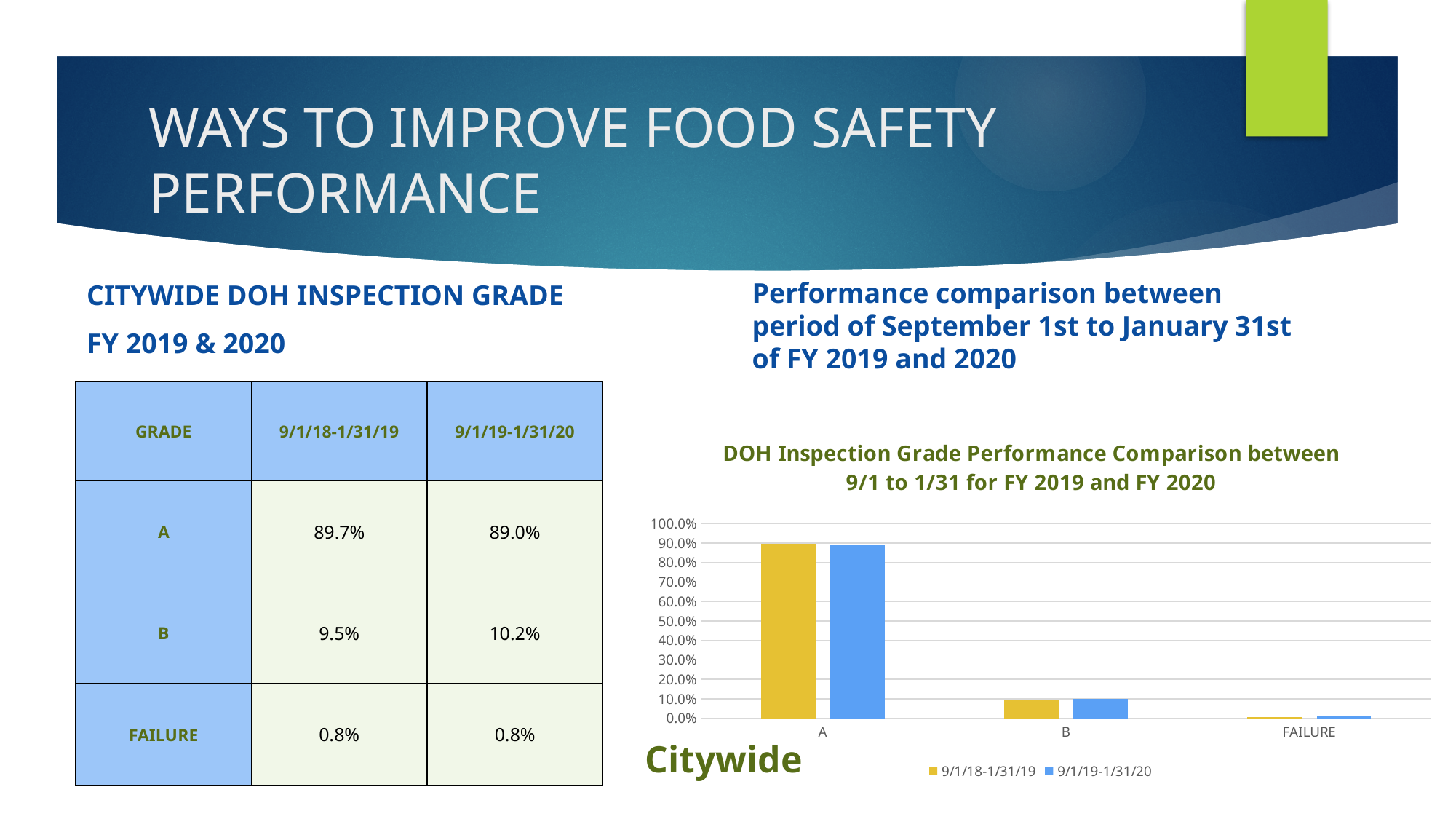
What is the value for grade A in the 9/1/19-1/31/20 period, as printed on the slide? 89.0% What colour are the bars for the 9/1/19-1/31/20 series? blue How many series does the chart legend list? 2 What is the difference between the grade B values for 9/1/19-1/31/20 and 9/1/18-1/31/19, as printed on the slide? 0.7% How many grade categories are shown on the x axis of the chart? 3 Which is larger for grade A: the 9/1/18-1/31/19 value or the 9/1/19-1/31/20 value? 9/1/18-1/31/19 Is the value for FAILURE in the 9/1/18-1/31/19 series greater or less than 10.0%? less What kind of chart is shown on the slide? bar chart Which grade category has the lowest bars in the chart? FAILURE Is the value for grade B in the 9/1/19-1/31/20 series greater or less than 20.0%? less Which grade category has the highest bars in the chart? A Is the value for grade A in the 9/1/18-1/31/19 series greater or less than 80.0%? greater